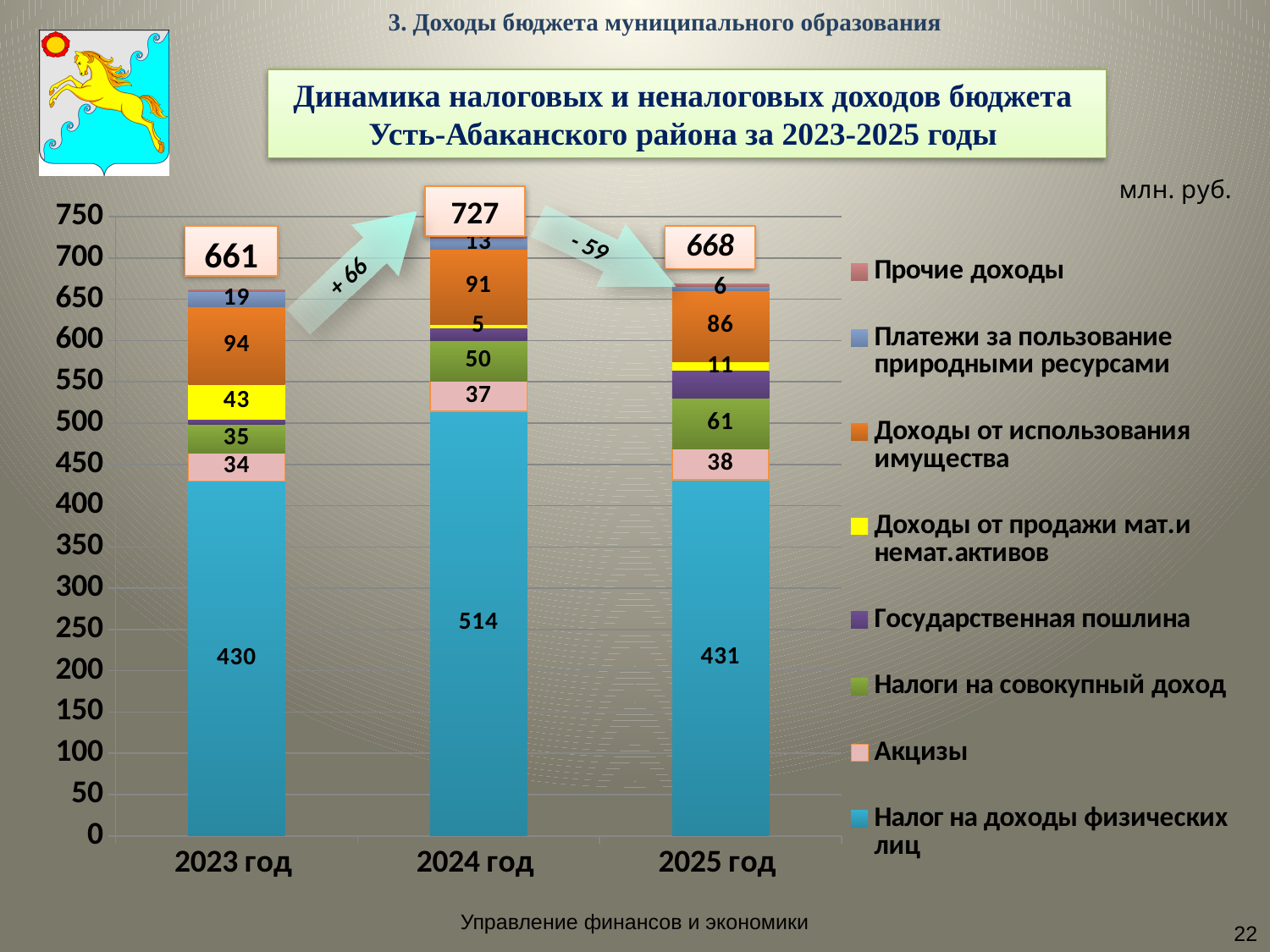
Which year has the lowest total? 2023 год How many series does the legend list? 8 What is the total for the 2023 год bar? 661 Which is larger: Акцизы in 2023 год or Акцизы in 2025 год? 2025 год What is the value of Доходы от использования имущества for 2023 год? 94 What is the value of Налоги на совокупный доход for 2025 год? 61 What is the total for the 2024 год bar? 727 What is the difference between the totals for 2024 год and 2025 год? 59 How many years (categories) are shown on the x axis? 3 What is the value of Налог на доходы физических лиц for 2024 год? 514 Which year has the highest total? 2024 год What type of chart is shown on the slide? stacked bar chart